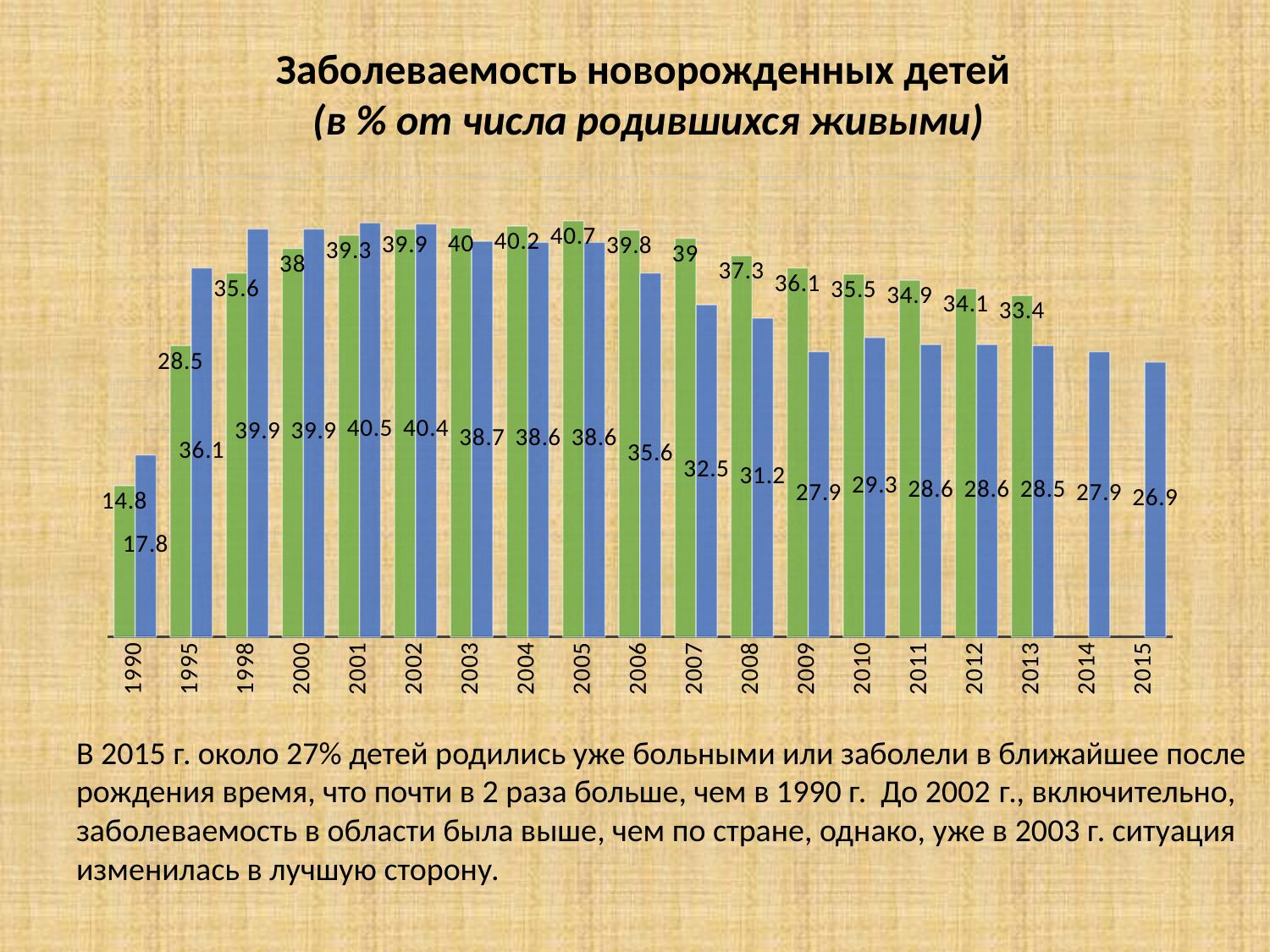
What is the difference between the green and blue bar values for 2013? 4.9 In which year is the green bar highest? 2005 In which year is the blue bar lowest? 1990 For 2001, which bar is larger, the green or the blue? Blue What type of chart is shown on the slide? Bar chart Do the blue bar values rise or fall from 2005 to 2015? Fall How many years are shown on the x axis of the chart? 19 What is the value of the green bar for 2005? 40.7 What is the difference between the blue bar values for 2015 and 1990? 9.1 Which years on the chart have only a blue bar and no green bar? 2014 and 2015 What is the value of the green bar for 1990? 14.8 What is the value of the blue bar for 2015? 26.9